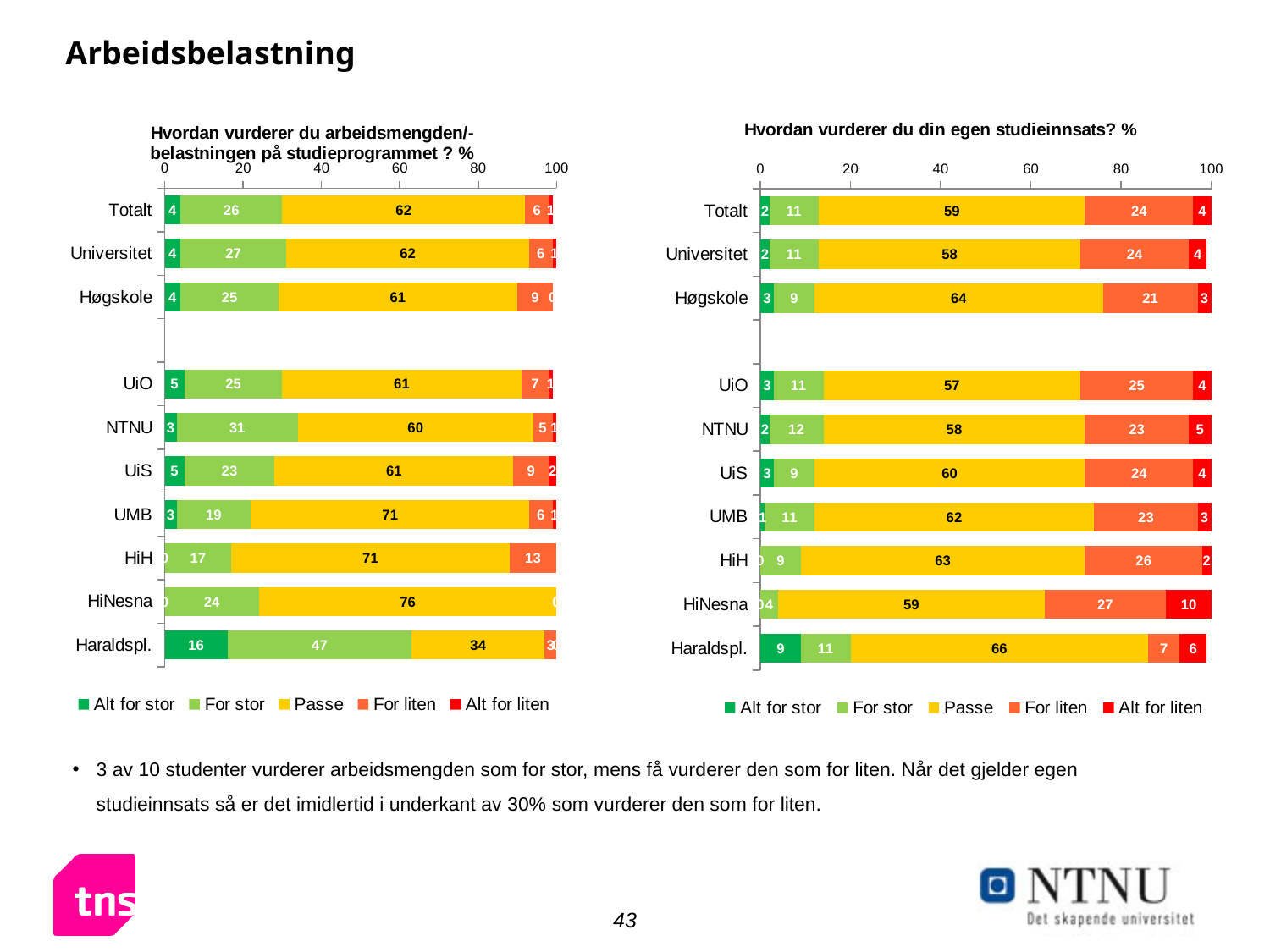
How many series does the legend of the right chart (egen studieinnsats) list? 5 What type of chart is used on this slide? Stacked bar chart In the left chart (arbeidsmengden/belastningen), what is the 'Passe' value for NTNU? 60 In the right chart (egen studieinnsats), what is the 'For liten' value for HiNesna? 27 In the left chart (arbeidsmengden/belastningen), which institution has the lowest 'Passe' value? Haraldspl. In the left chart (arbeidsmengden/belastningen), is the 'For stor' value larger for NTNU or for UiS? NTNU In the right chart (egen studieinnsats), which institution has the highest 'Alt for liten' value? HiNesna In the right chart (egen studieinnsats), what is the 'Passe' value for Høgskole? 64 In the left chart (arbeidsmengden/belastningen), which institution has the highest 'Passe' value? HiNesna In the left chart (arbeidsmengden/belastningen), what is the 'For stor' value for Haraldspl.? 47 How many institution/category rows are plotted in the left chart (arbeidsmengden/belastningen)? 10 In the right chart (egen studieinnsats), what is the difference between the 'Passe' values for Haraldspl. and UiO? 9